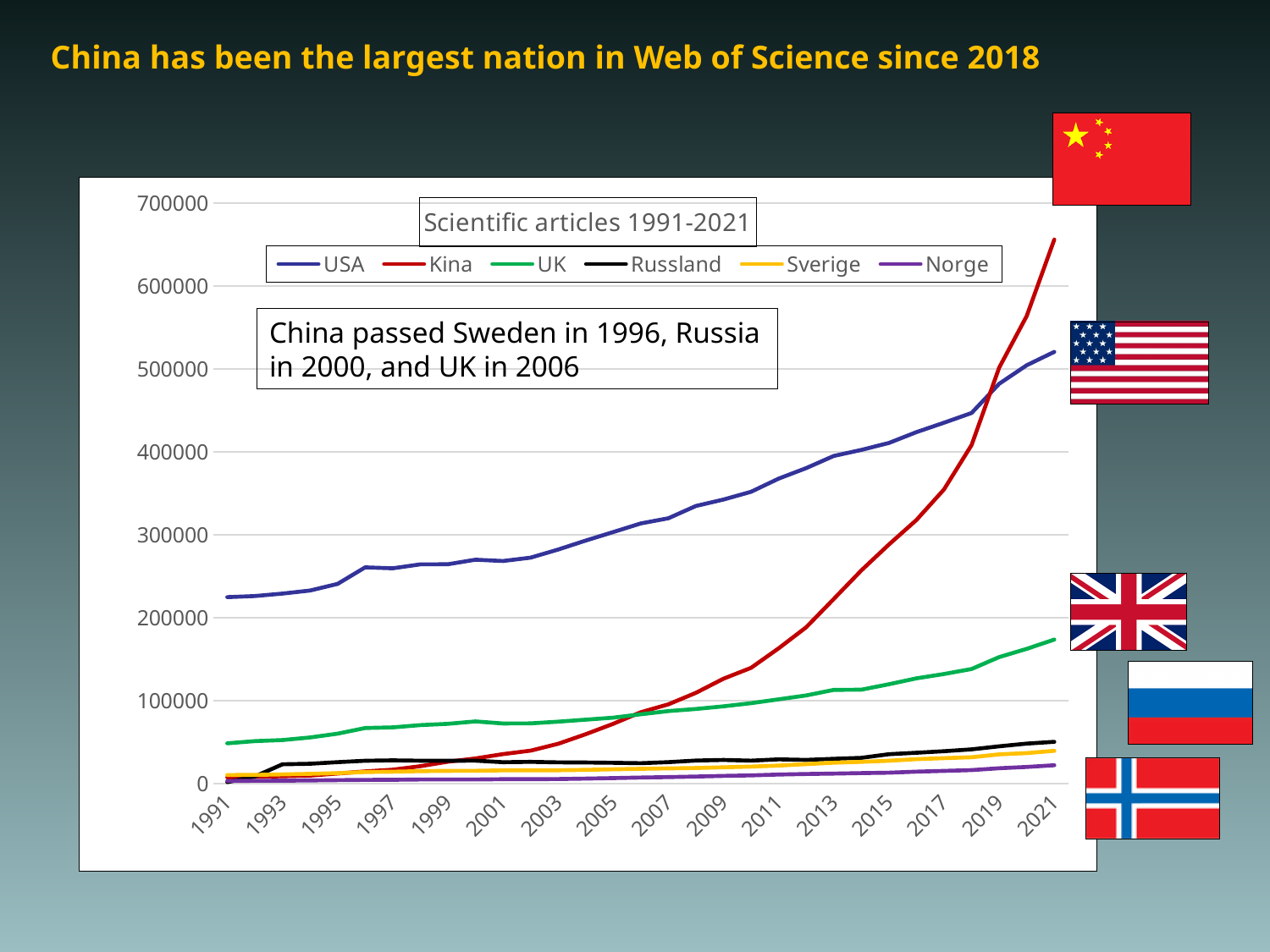
Is the value for UK in 2021 greater or less than 200000? less Does the USA series generally rise or fall from 1991 to 2021? rise What is the title of the chart? Scientific articles 1991-2021 Which series has the highest value in 2021? Kina Which series has the highest value in 1991? USA Is the value for Kina in 2021 greater or less than 600000? greater How many series does the chart legend list? 6 Is the value for USA in 1991 greater or less than 200000? greater What kind of chart is shown on the slide? line chart Which series has the lowest value in 2021? Norge Which series is drawn in green in the chart? UK In 2021, which is larger: the value for UK or the value for Russland? UK